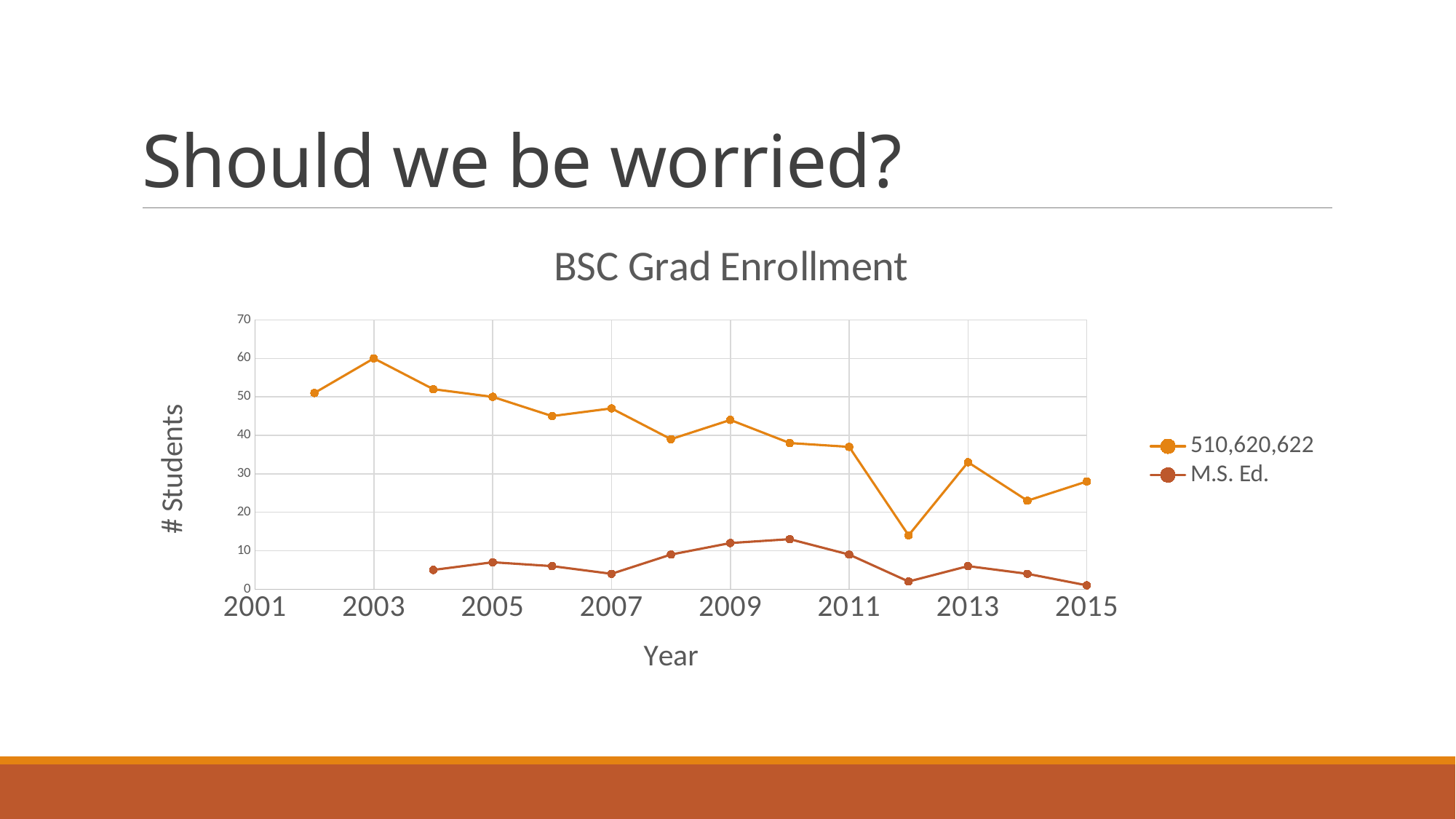
Is the value for the 510,620,622 series in 2002 greater or less than 40? greater What kind of chart is shown on the slide? line chart Is the value for the 510,620,622 series in 2012 greater or less than 20? less Does the 510,620,622 series generally rise or fall from 2003 to 2012? fall What is the title of the chart? BSC Grad Enrollment Is the value for the M.S. Ed. series in 2010 greater or less than 10? greater What is the label on the vertical axis? # Students In 2009, which series has the higher value, 510,620,622 or M.S. Ed.? 510,620,622 In which year does the 510,620,622 series reach its lowest value? 2012 How many series does the legend list? 2 In which year does the 510,620,622 series reach its highest value? 2003